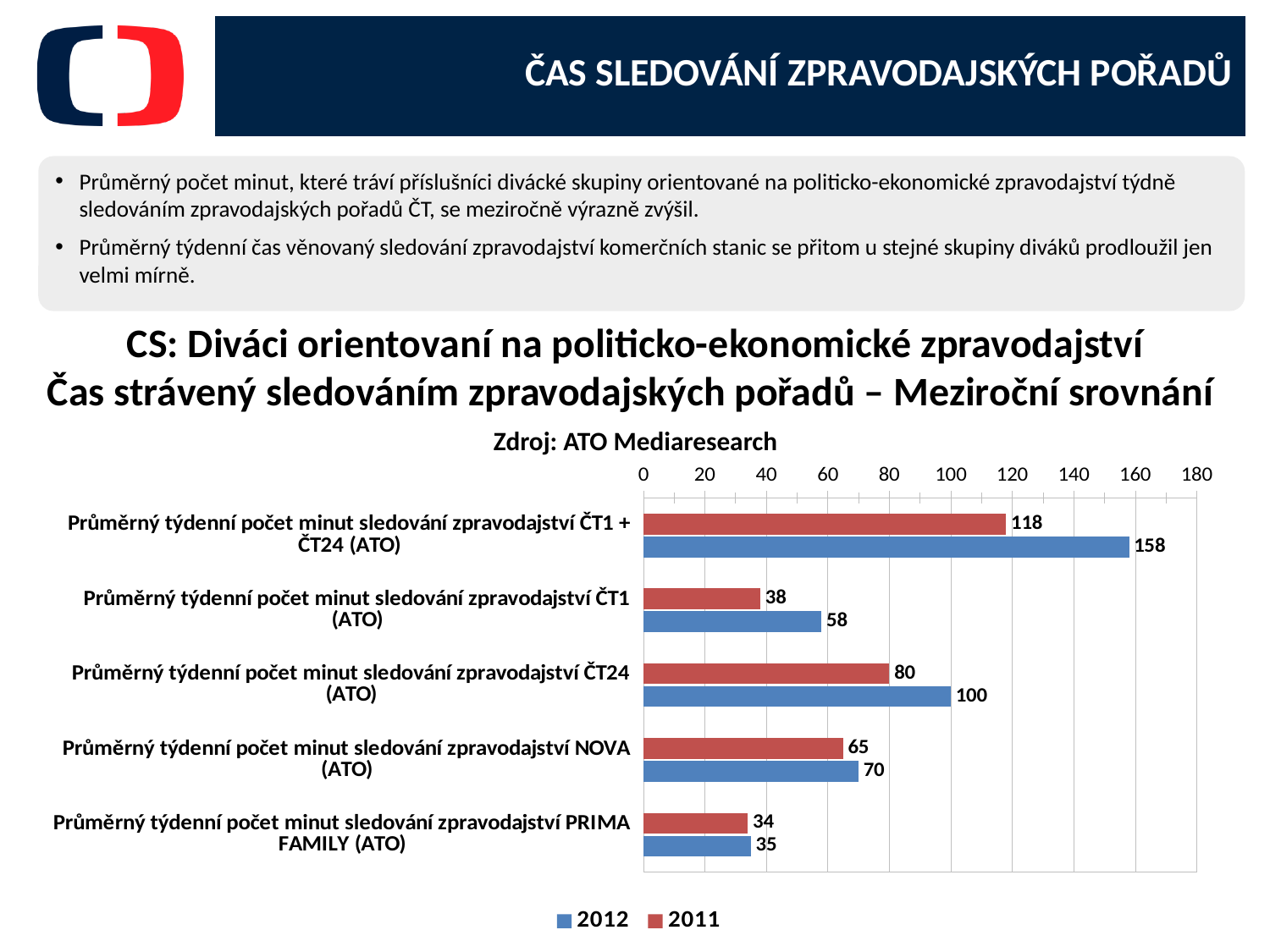
How many series does the legend list? 2 What source is cited for the chart? ATO Mediaresearch What is the difference between the 2012 and 2011 values for Průměrný týdenní počet minut sledování zpravodajství ČT1 + ČT24 (ATO)? 40 What is the 2012 value for Průměrný týdenní počet minut sledování zpravodajství ČT1 + ČT24 (ATO)? 158 Which category has the highest 2012 value? Průměrný týdenní počet minut sledování zpravodajství ČT1 + ČT24 (ATO) Which category has the lowest 2011 value? Průměrný týdenní počet minut sledování zpravodajství PRIMA FAMILY (ATO) How many categories are shown on the chart? 5 What is the 2012 value for Průměrný týdenní počet minut sledování zpravodajství ČT24 (ATO)? 100 What kind of chart is shown on the slide? bar chart What is the 2011 value for Průměrný týdenní počet minut sledování zpravodajství NOVA (ATO)? 65 Is the 2012 value for Průměrný týdenní počet minut sledování zpravodajství NOVA (ATO) greater or less than 60? greater Which is larger for Průměrný týdenní počet minut sledování zpravodajství ČT1 (ATO): the 2012 value or the 2011 value? 2012